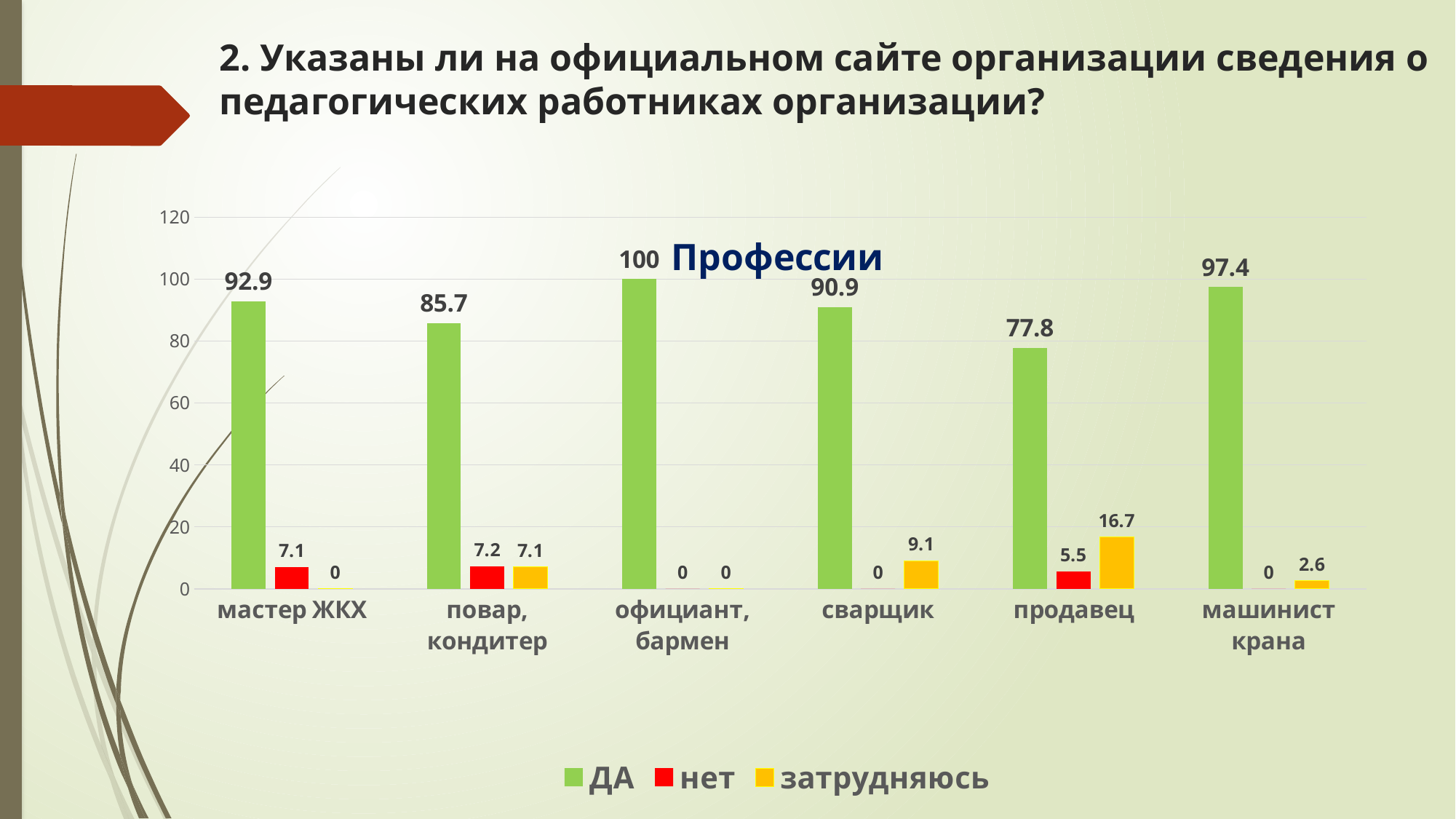
How many series does the legend list? 3 Which is larger: the ДА value for сварщик or the ДА value for повар, кондитер? сварщик Is the ДА value for продавец greater or less than 80? less What is the value of the нет series for повар, кондитер? 7.2 How many professions are shown on the x axis? 6 Which profession has the highest value in the затрудняюсь series? продавец What colour represents the нет series in the chart? red What is the value of the затрудняюсь series for продавец? 16.7 What is the difference between the ДА values for машинист крана and мастер ЖКХ? 4.5 What kind of chart is shown on the slide? bar chart What is the value of the ДА series for официант, бармен? 100 Which profession has the lowest value in the ДА series? продавец